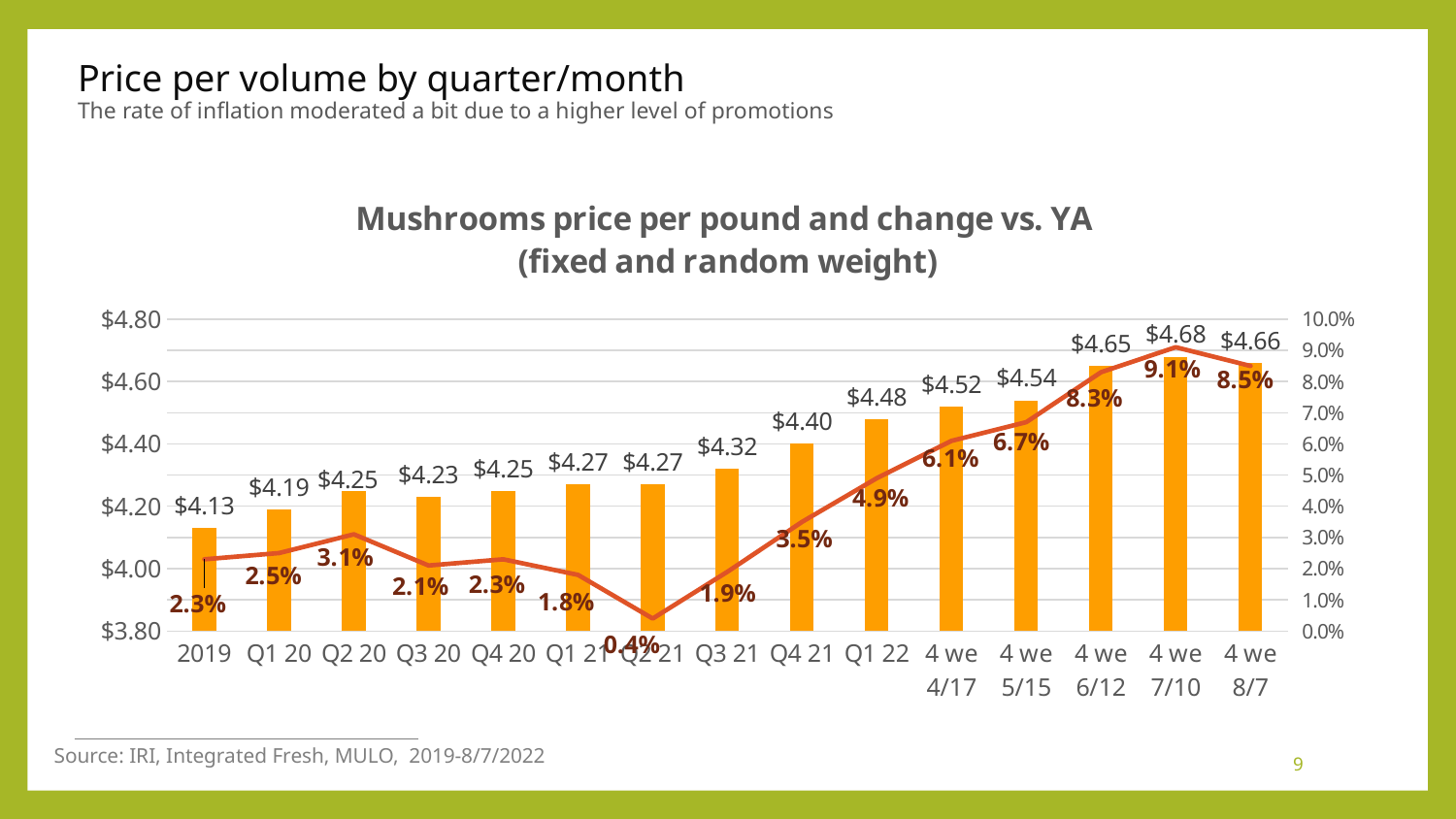
What is the title of the chart? Mushrooms price per pound and change vs. YA (fixed and random weight) Which period has the highest price per pound? 4 we 7/10 Which is larger, the change vs. YA for Q4 21 or for Q1 22? Q1 22 What is the mushrooms price per pound for Q1 22? $4.48 Which period has the lowest change vs. YA? Q2 21 What is the price per pound shown for 2019? $4.13 How many periods are shown on the x axis? 15 What is the change vs. YA for Q3 21? 1.9% What kind of chart is this? Combined bar and line chart What is the change vs. YA shown for the 4 we 7/10 period? 9.1% What is the difference in price per pound between 4 we 8/7 and 2019? $0.53 Does the price per pound generally rise or fall from 2019 to 4 we 7/10? Rise